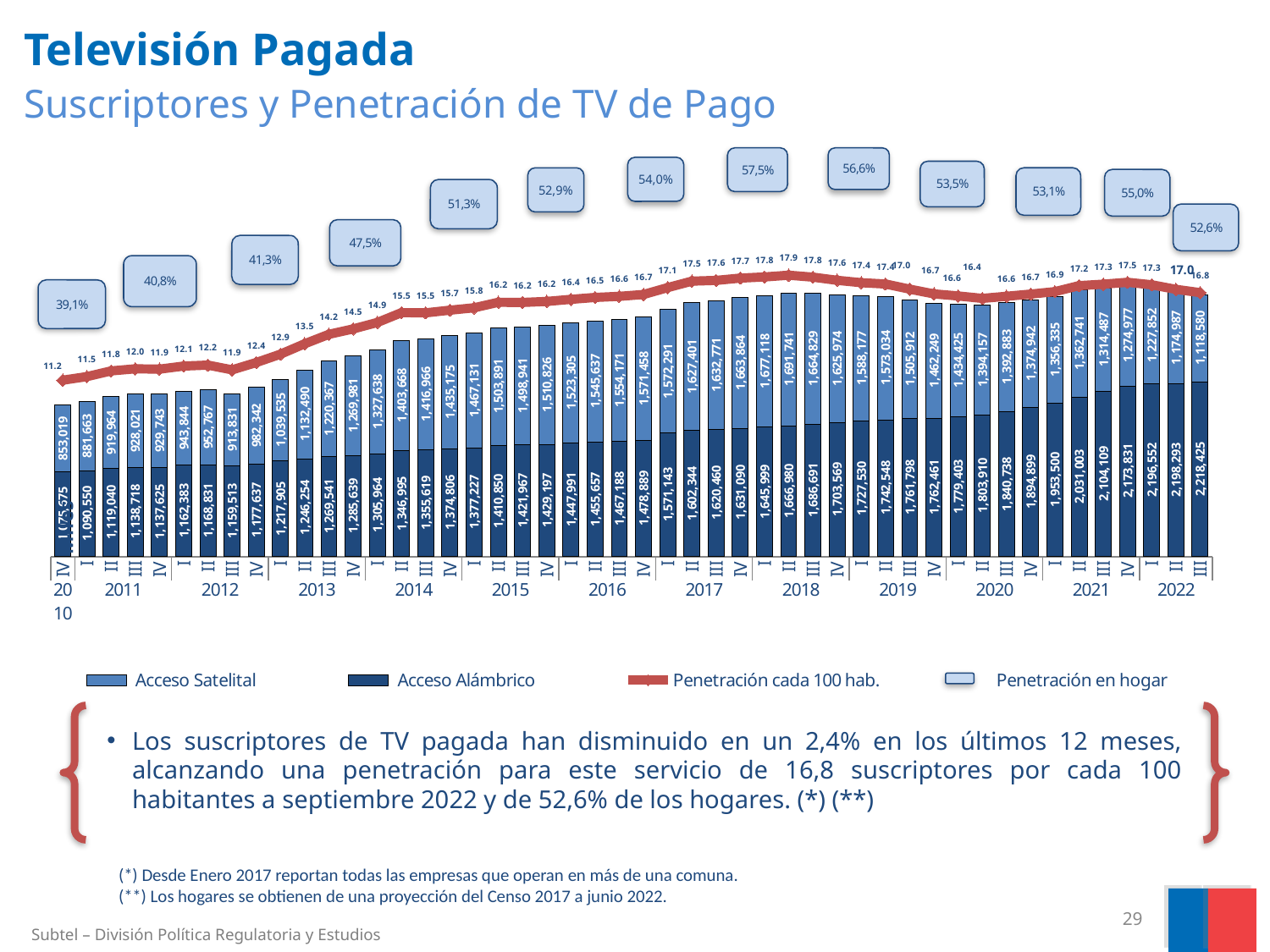
How many series does the legend list? 4 By how many percentage points did Penetración en hogar fall from 2021 to 2022? 2,4 What is the Penetración en hogar value shown for 2017? 57,5% Which year has the highest Penetración en hogar value? 2017 What is the Acceso Alámbrico value for III 2022? 2,218,425 What is the Penetración cada 100 hab. value at III 2022? 16.8 What is the total of the stacked bar for III 2022 (Acceso Alámbrico plus Acceso Satelital)? 3,337,005 What kind of chart is shown on the slide? A stacked bar chart combined with a line Which year has the lowest Penetración en hogar value? 2010 What is the Acceso Satelital value for III 2022? 1,118,580 In which quarter does Acceso Satelital reach its highest value? II 2018 In III 2022, which is larger: Acceso Alámbrico or Acceso Satelital? Acceso Alámbrico